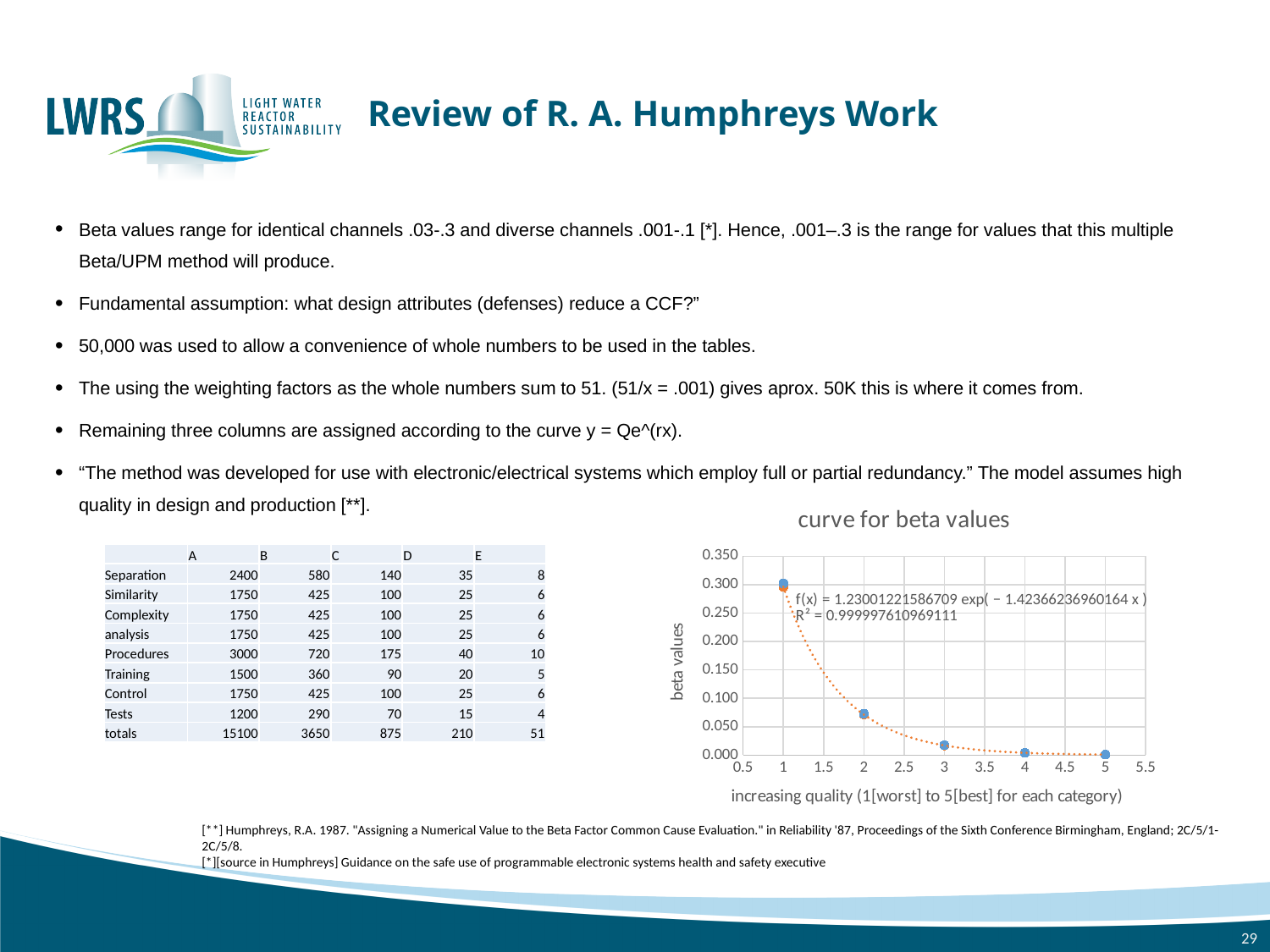
What kind of chart is "curve for beta values"? scatter chart In the "curve for beta values" chart, is the beta value at x = 2 greater or less than 0.100? less In the "curve for beta values" chart, which x value has the highest beta value? 1 What is the title of the chart on the slide? curve for beta values In the "curve for beta values" chart, which is larger: the beta value at x = 2 or at x = 4? x = 2 In the "curve for beta values" chart, is the beta value at x = 1 greater or less than 0.250? greater What is the label of the y axis in the "curve for beta values" chart? beta values In the "curve for beta values" chart, is the beta value at x = 3 greater or less than 0.050? less In the "curve for beta values" chart, do the beta values rise or fall as quality increases along the x axis? fall